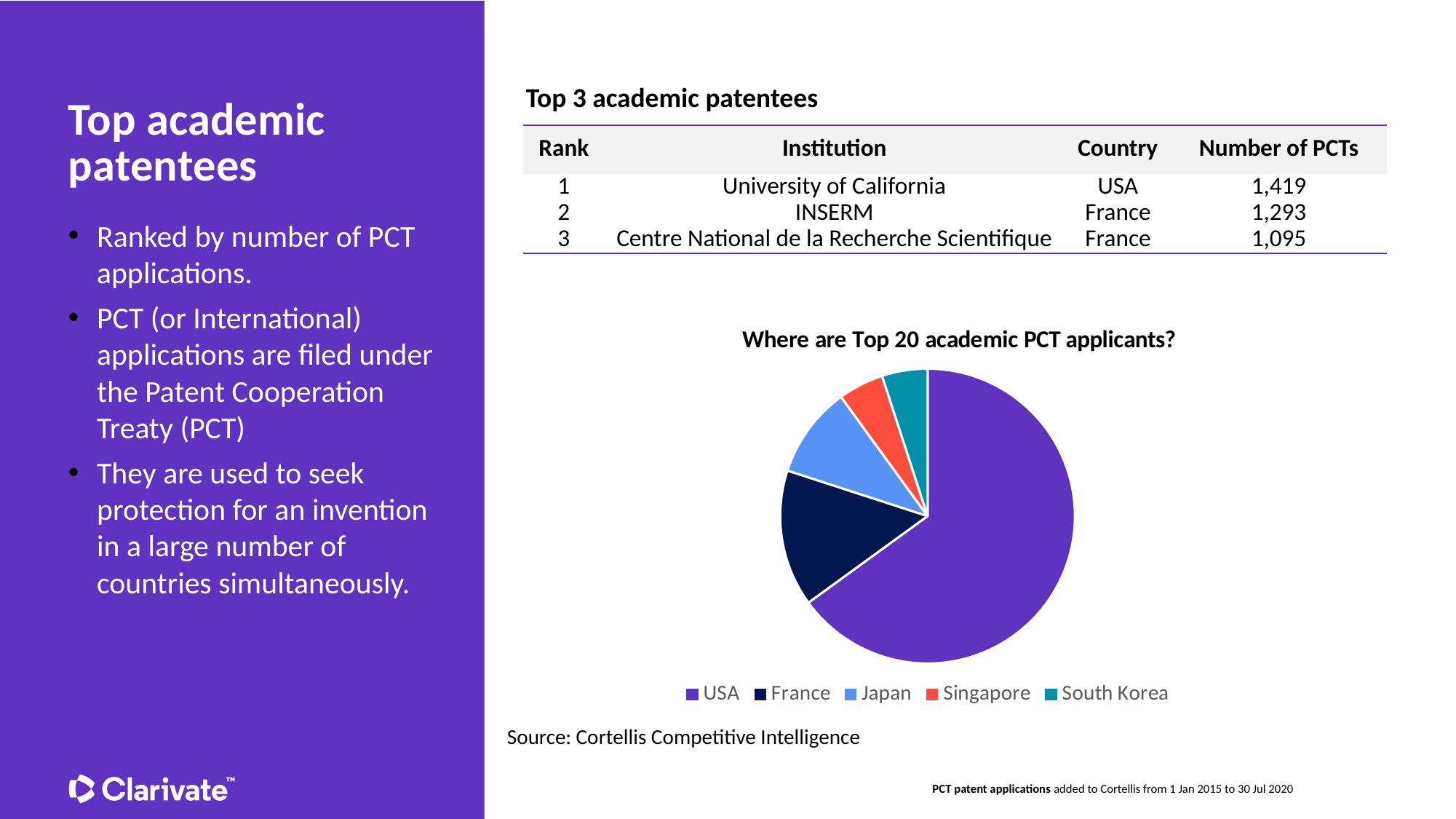
Does the USA slice of the pie chart cover more or less than half of the pie? more How many countries does the legend of the pie chart list? 5 What kind of chart is shown under the title "Where are Top 20 academic PCT applicants?"? pie chart Which country has the largest slice in the pie chart? USA Which country is shown in the last (rightmost) legend entry of the pie chart? South Korea In the pie chart, which slice is larger, France or Japan? France In the pie chart, which slice is larger, USA or France? USA What is the title of the pie chart? Where are Top 20 academic PCT applicants? In the pie chart, which slice is larger, Japan or Singapore? Japan Which country has the second-largest slice in the pie chart? France